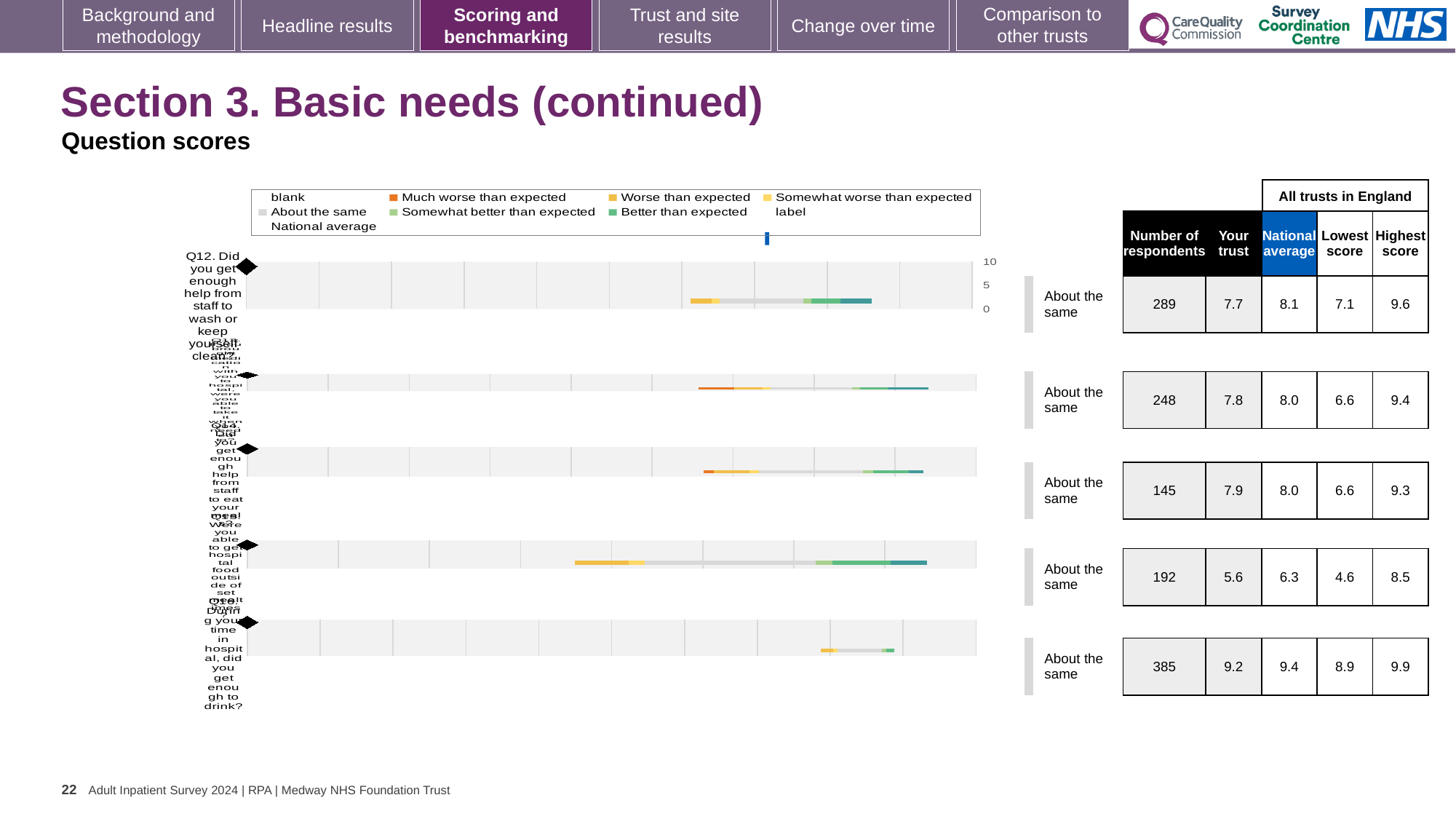
How many respondents are listed for Q12, the first row of the chart? 289 What benchmark category is shown beside every row of the chart? About the same What does the blue vertical marker in the chart legend represent? National average What kind of chart is used to show the question scores on this slide? bar chart How many question rows (bars) are plotted in the chart? 5 What is the 'Highest score' value for the fourth row of the chart? 8.5 For Q12, what is the difference between the National average (8.1) and the Your trust score (7.7)? 0.4 What is the highest 'Your trust' score shown in the table next to the chart? 9.2 What is the 'Lowest score' value for the fifth row of the chart? 8.9 What is the 'Your trust' score for Q12 (help from staff to wash or keep yourself clean)? 7.7 What is the lowest 'Your trust' score shown in the table next to the chart? 5.6 For the first row (Q12), which is larger: the Your trust score or the National average? National average